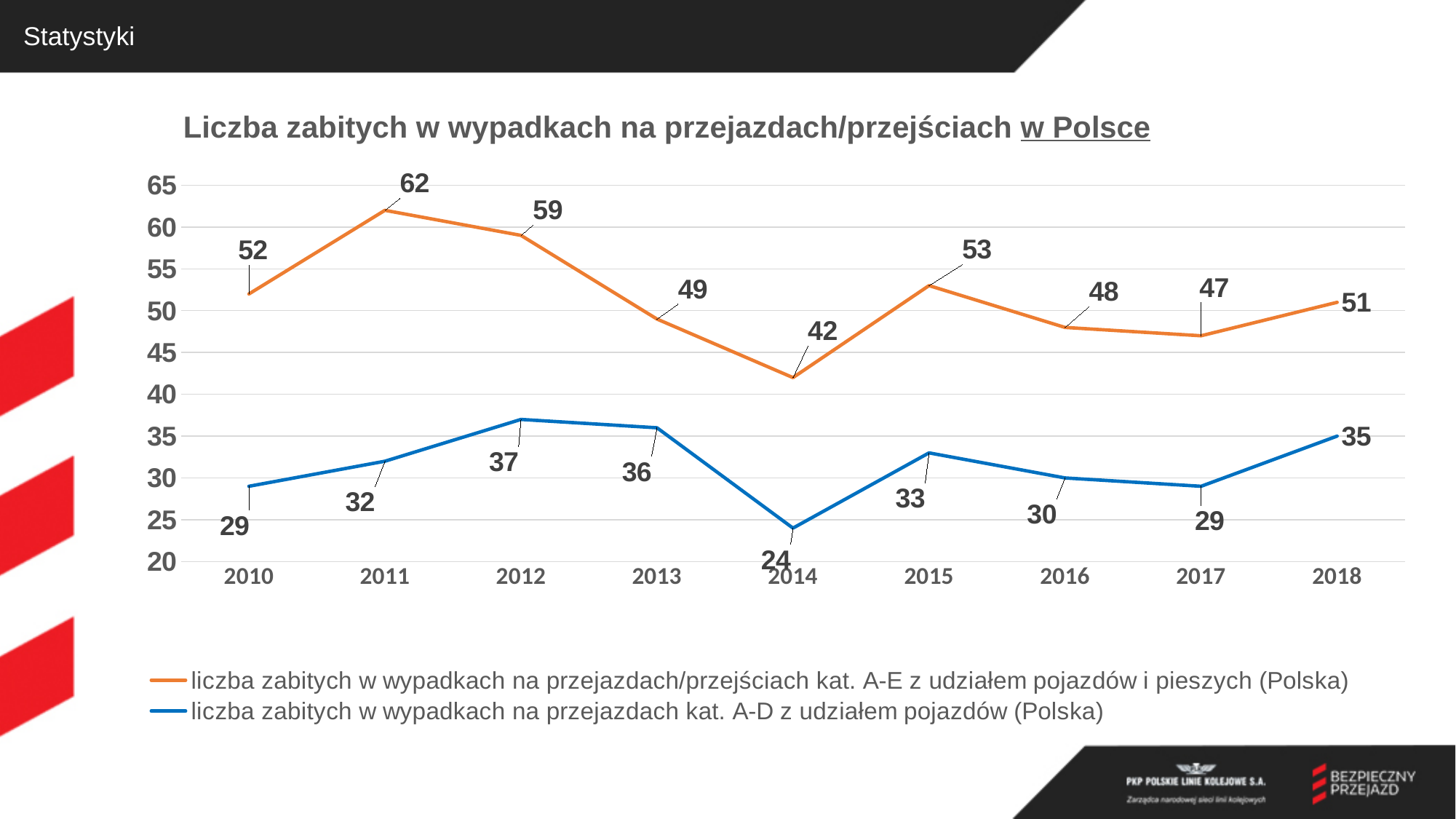
What is the title of the chart? Liczba zabitych w wypadkach na przejazdach/przejściach w Polsce In which year is the orange series (kat. A-E) highest? 2011 How many years are shown on the x axis? 9 How many series does the legend list? 2 What is the value of the orange series (kat. A-E z udziałem pojazdów i pieszych) in 2011? 62 What is the value of the blue series (kat. A-D z udziałem pojazdów) in 2014? 24 Does the blue series (kat. A-D) rise or fall from 2017 to 2018? rise Which is larger: the orange series (kat. A-E) value in 2012 or in 2015? 2012 What is the difference between the orange series (kat. A-E) and the blue series (kat. A-D) in 2010? 23 What kind of chart is shown on the slide? line chart What is the value of the orange series (kat. A-E) in 2018? 51 In which year is the blue series (kat. A-D) lowest? 2014